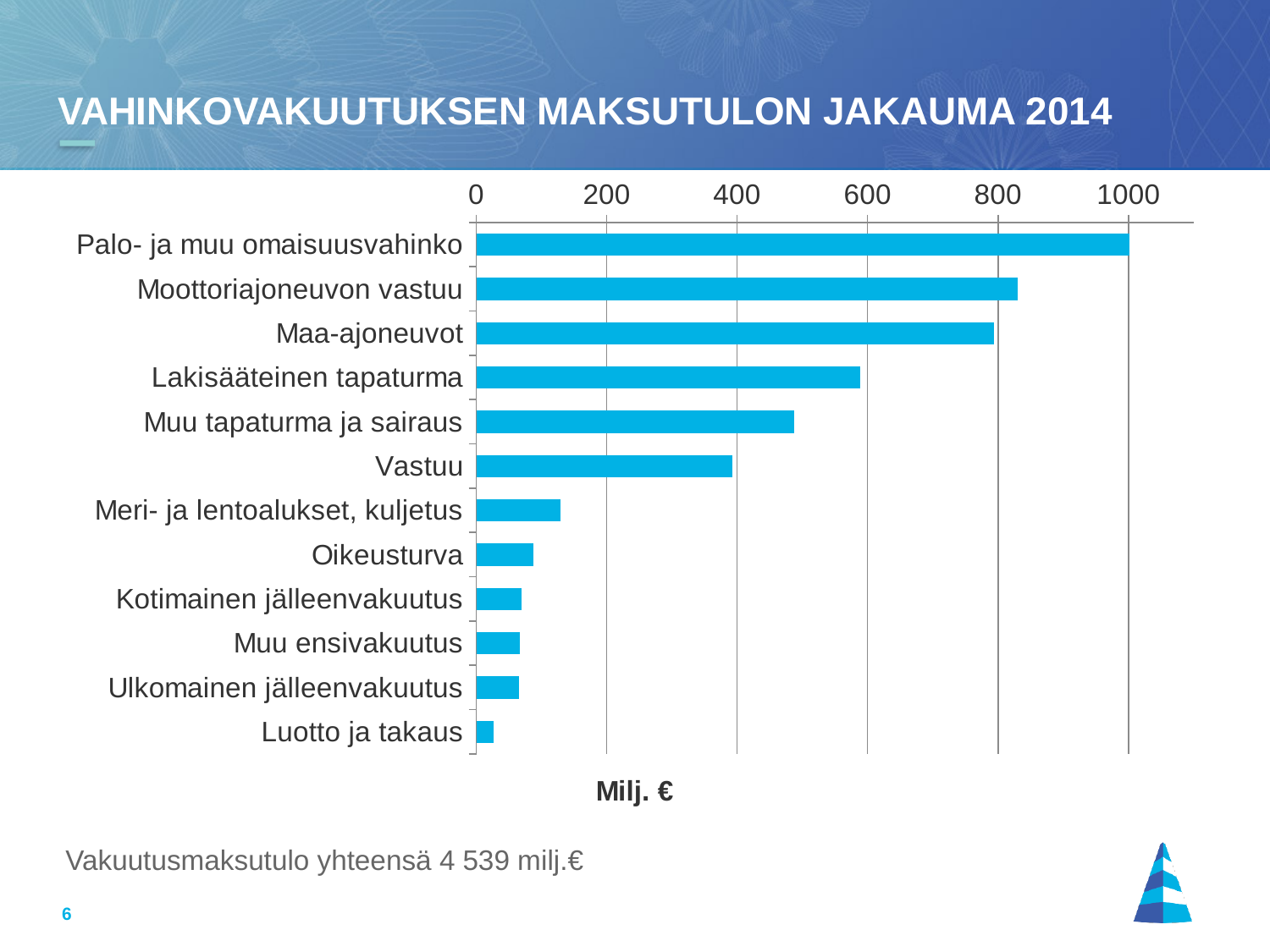
Which category has the highest value? Palo- ja muu omaisuusvahinko Is the value for Moottoriajoneuvon vastuu greater or less than 800? greater Is the value for Muu tapaturma ja sairaus greater or less than 400? greater Is the value for Meri- ja lentoalukset, kuljetus greater or less than 200? less What kind of chart is shown on the slide? bar chart What unit is shown on the value axis of the chart? Milj. € Which category has the lowest value? Luotto ja takaus Which is larger, the value for Moottoriajoneuvon vastuu or the value for Lakisääteinen tapaturma? Moottoriajoneuvon vastuu How many categories are shown in the chart? 12 What is the title of the slide containing the chart? VAHINKOVAKUUTUKSEN MAKSUTULON JAKAUMA 2014 Which is larger, the value for Vastuu or the value for Oikeusturva? Vastuu